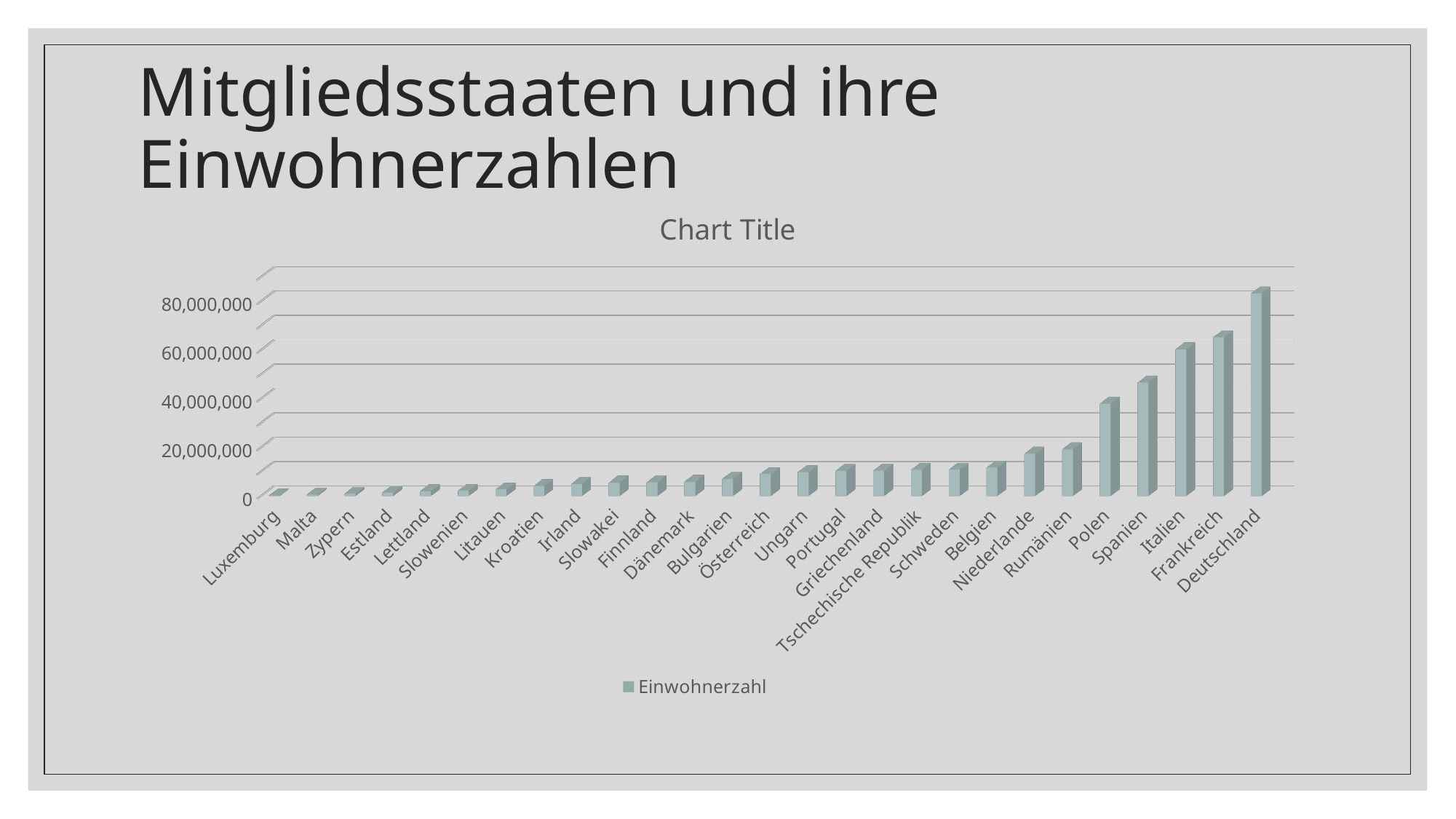
Is the value for Rumänien greater or less than 40,000,000? less Which country has the highest value in the chart? Deutschland Do the values rise or fall from left to right along the x axis? rise What series name is shown in the chart legend? Einwohnerzahl Which has the larger value, Spanien or Italien? Italien How many series does the chart legend list? 1 How many countries are shown on the x axis of the chart? 27 Which has the larger value, Polen or Rumänien? Polen What kind of chart is shown on the slide? bar chart Which has the larger value, Deutschland or Frankreich? Deutschland Is the value for Frankreich greater or less than 60,000,000? greater Is the value for Deutschland greater or less than 80,000,000? greater